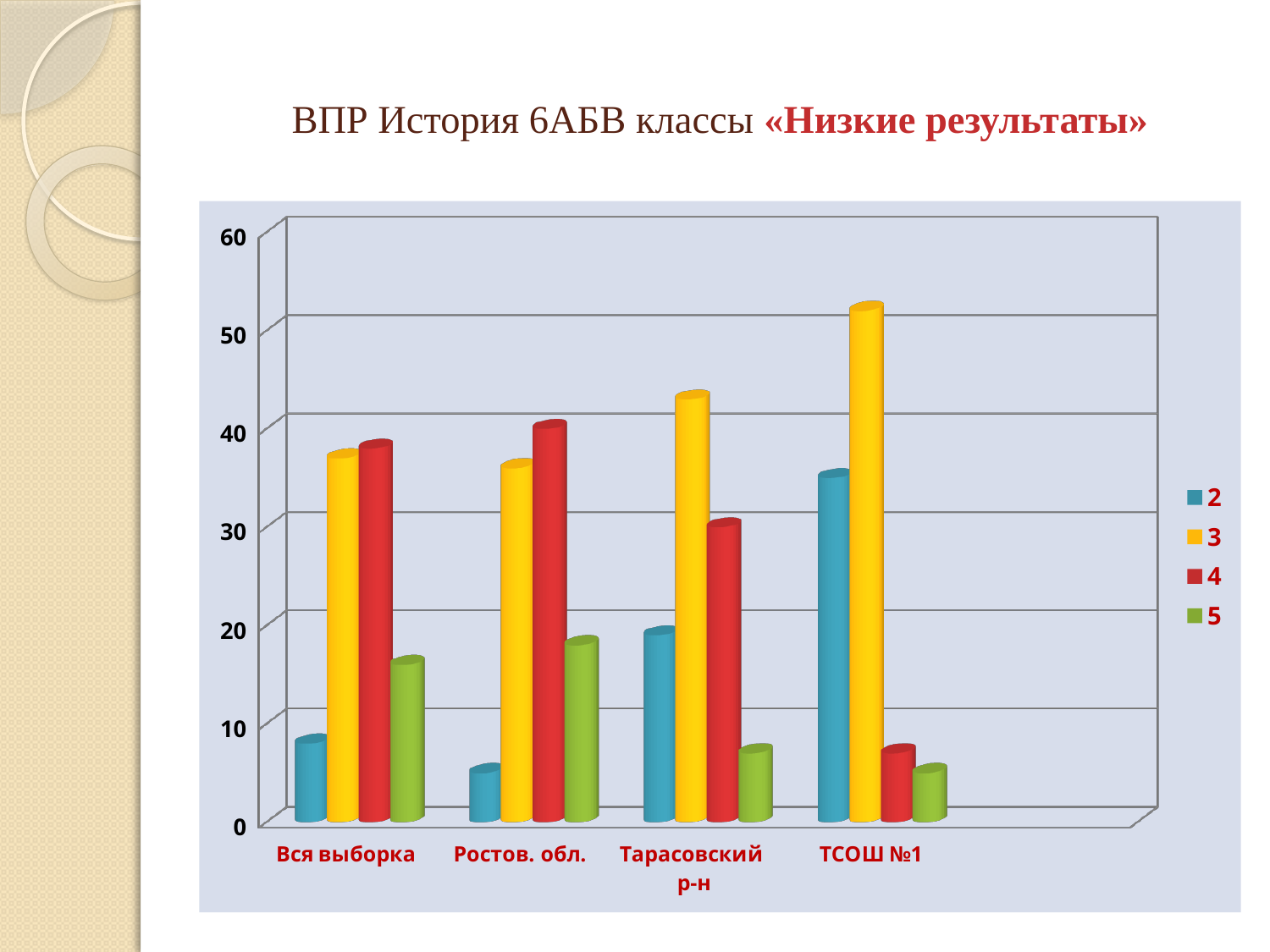
Which category has the lowest value for series 4? ТСОШ №1 In Тарасовский р-н, which is larger: the value for series 2 or the value for series 5? series 2 How many categories are shown on the x axis? 4 Is the value for series 4 in Тарасовский р-н greater or less than 20? greater Which category has the highest value for series 2? ТСОШ №1 Is the value for series 2 in Вся выборка greater or less than 10? less Which category has the highest value for series 3? ТСОШ №1 How many series does the legend list? 4 Which is larger: the value for series 2 in ТСОШ №1 or the value for series 2 in Вся выборка? ТСОШ №1 What entries are listed in the legend? 2, 3, 4, 5 Is the value for series 3 in ТСОШ №1 greater or less than 50? greater What kind of chart is shown on the slide? bar chart